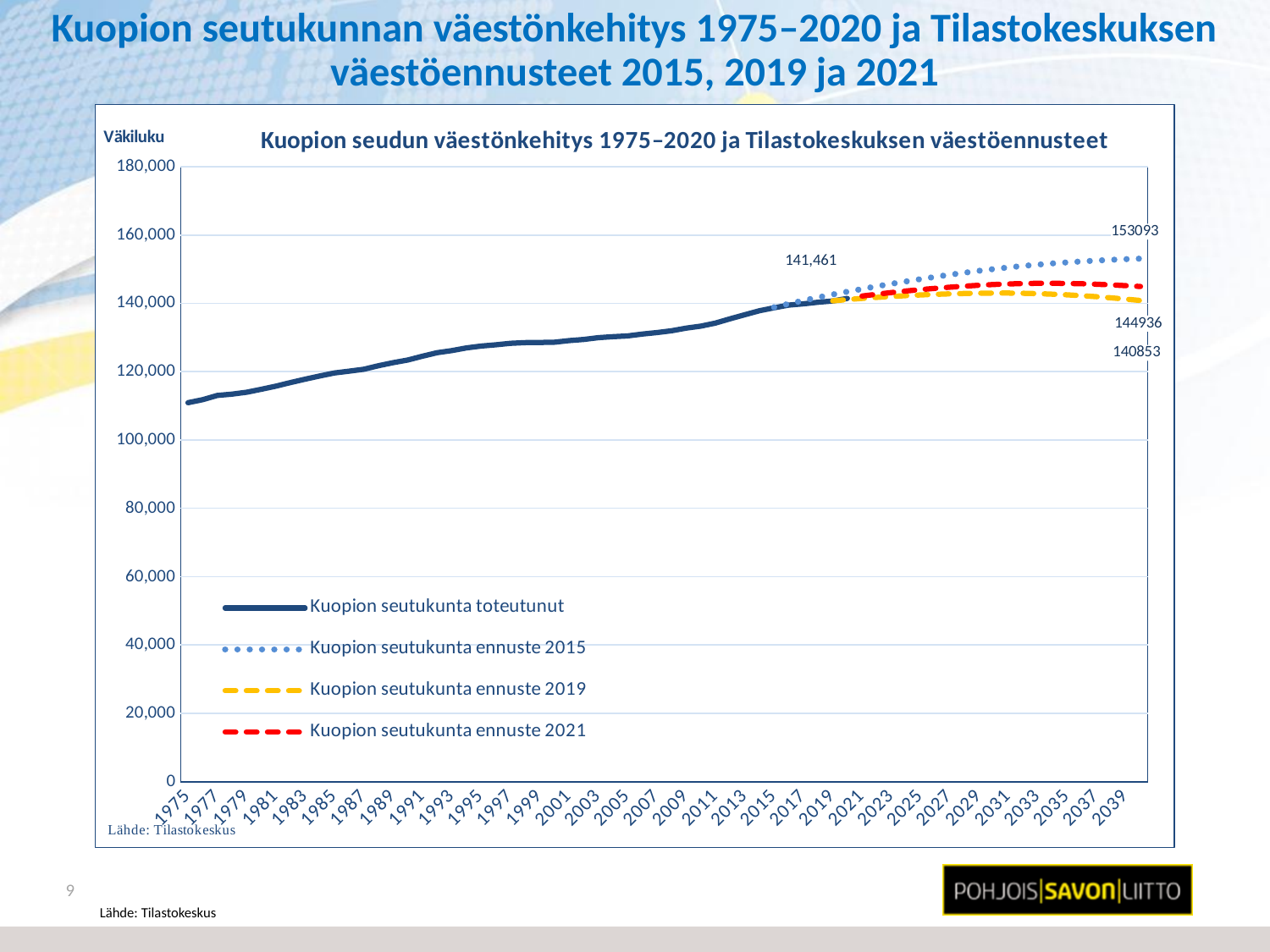
Which ends higher, the ennuste 2021 series or the ennuste 2019 series? Kuopion seutukunta ennuste 2021 Does the 'Kuopion seutukunta toteutunut' series rise or fall from 1975 to 2020? rise Which forecast series ends at the lowest value? Kuopion seutukunta ennuste 2019 What value is labelled at the end of the 'Kuopion seutukunta toteutunut' series? 141,461 How many series does the legend list? 4 What is the difference between the end values of the ennuste 2015 and ennuste 2019 series? 12240 Which forecast series ends at the highest value? Kuopion seutukunta ennuste 2015 What kind of chart is shown on the slide? line chart Is the value of the 'Kuopion seutukunta toteutunut' series in 1975 greater or less than 120,000? less What is the labelled end value of the 'Kuopion seutukunta ennuste 2019' series? 140853 What is the labelled end value of the 'Kuopion seutukunta ennuste 2021' series? 144936 What is the labelled end value of the 'Kuopion seutukunta ennuste 2015' series? 153093